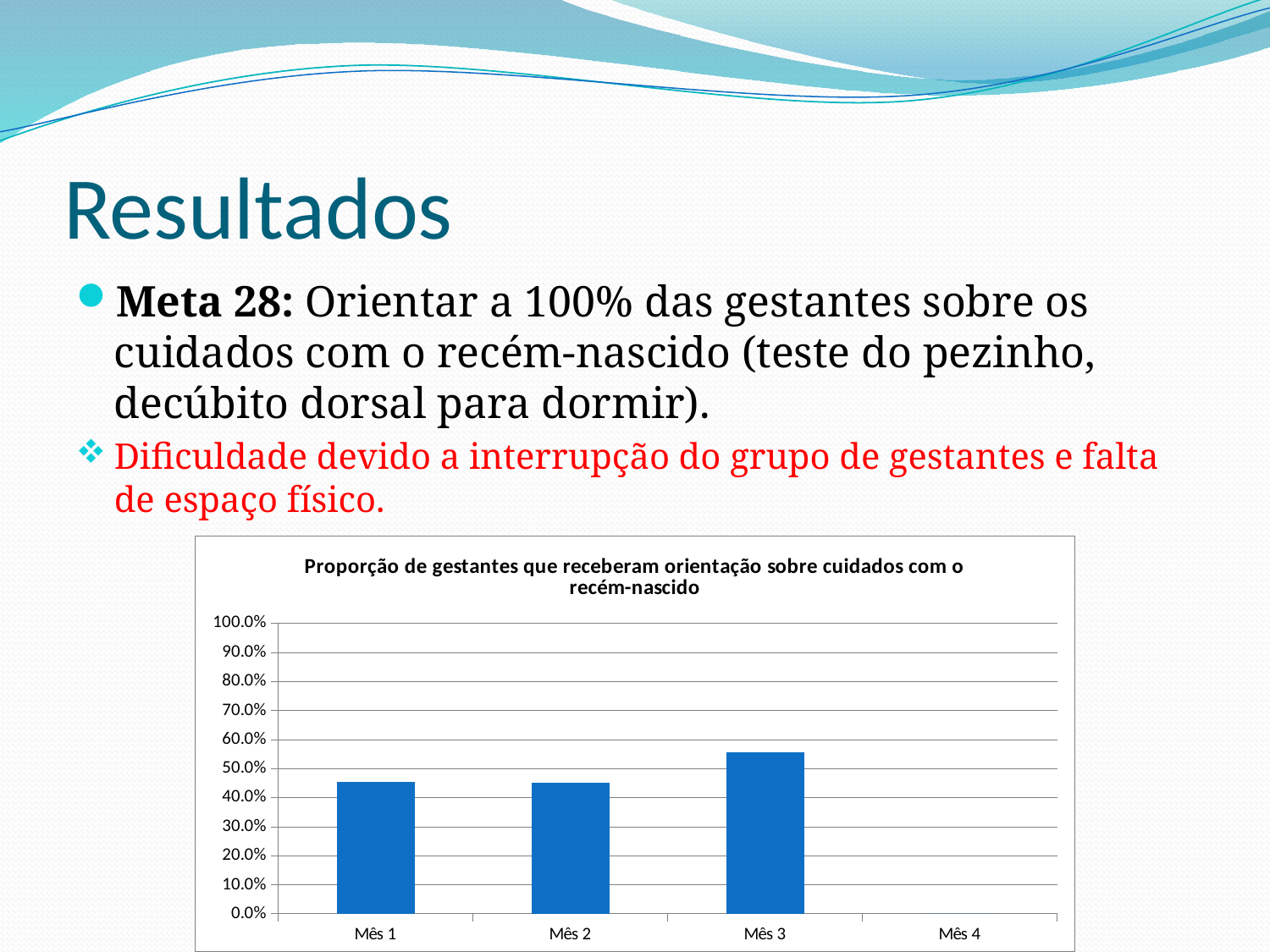
Is the value for Mês 1 greater or less than 50.0%? less Which is larger, the value for Mês 2 or the value for Mês 3? Mês 3 Is the value for Mês 1 greater or less than 40.0%? greater Which category on the x axis has no visible bar? Mês 4 Which month has the highest value in the chart? Mês 3 What is the title of the chart? Proporção de gestantes que receberam orientação sobre cuidados com o recém-nascido What kind of chart is shown on the slide? bar chart Is the value for Mês 2 greater or less than 40.0%? greater How many categories are shown on the x axis of the chart? 4 Which is larger, the value for Mês 3 or the value for Mês 1? Mês 3